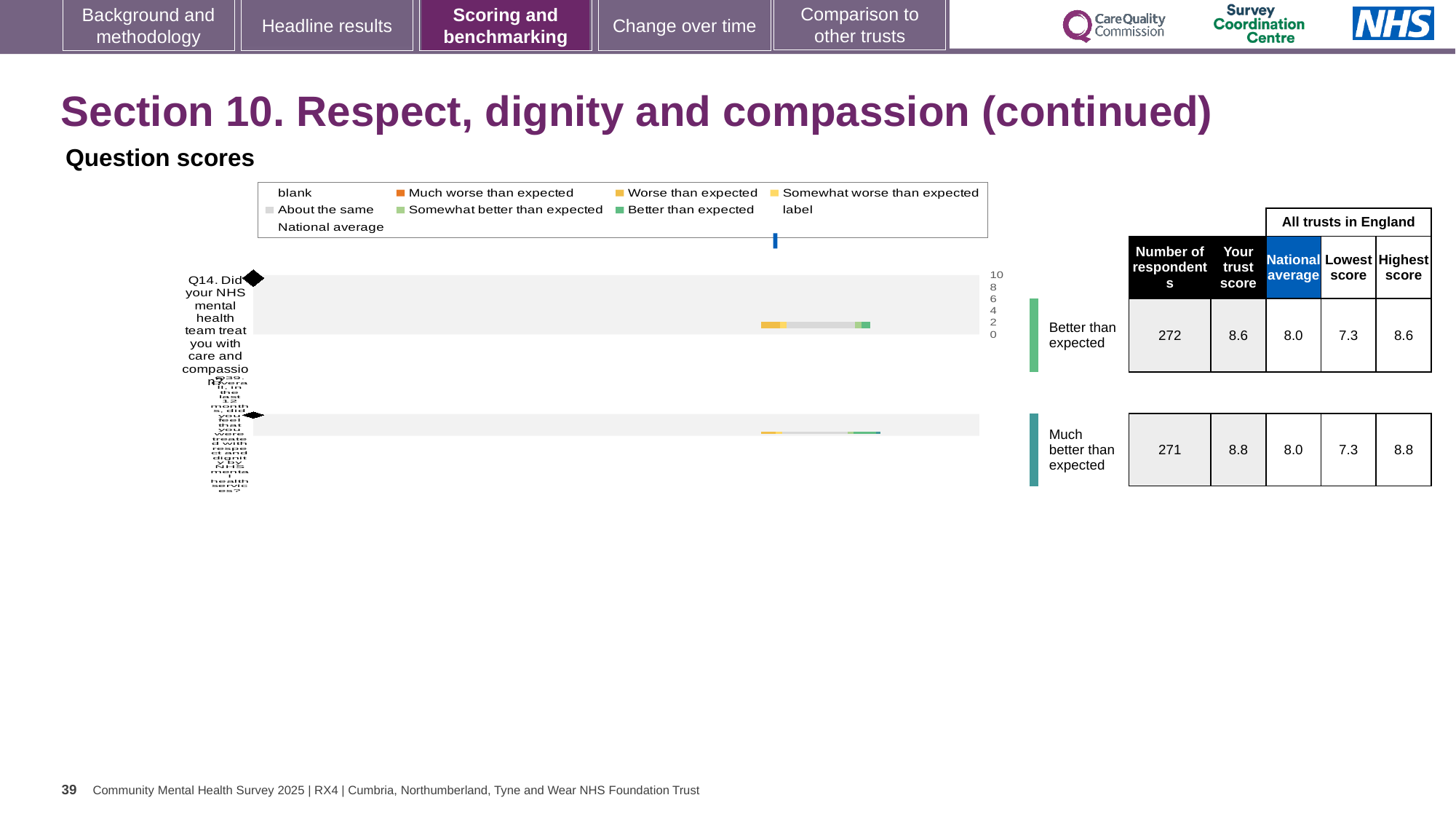
What is the lowest score among all trusts in England for Q39? 7.3 What benchmark category is shown next to the Q39 chart? Much better than expected What is the highest score among all trusts in England for Q14? 8.6 What is the trust score for Q14 (Did your NHS mental health team treat you with care and compassion?)? 8.6 What is the trust score for Q39? 8.8 What is the national average score for Q14? 8.0 How many questions are plotted on the chart? 2 By how much does the trust score for Q14 exceed the national average? 0.6 How many respondents answered Q39? 271 How many respondents answered Q14? 272 By how much does the trust score for Q39 exceed the national average? 0.8 Which question has the higher trust score, Q14 or Q39? Q39